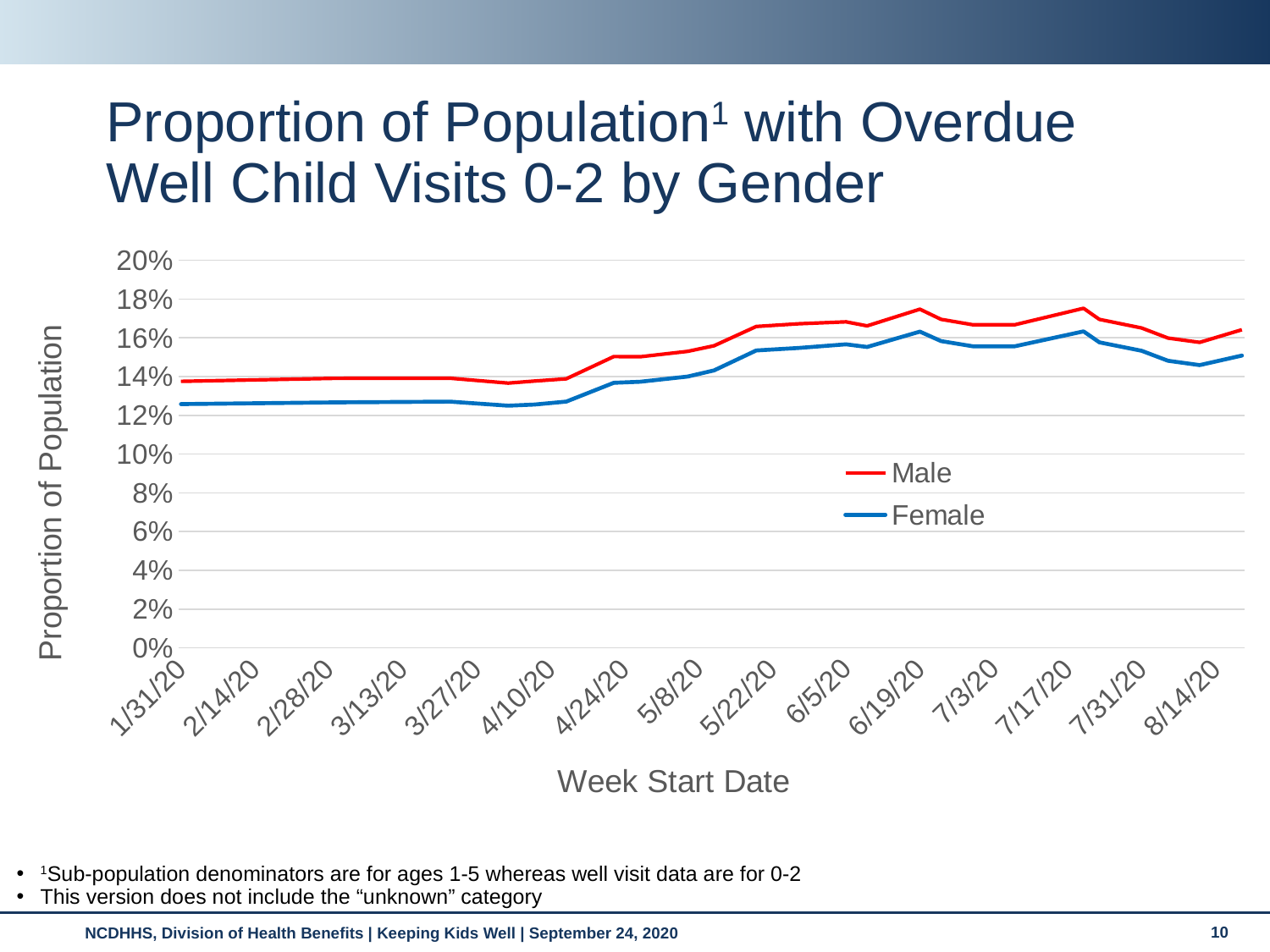
What kind of chart is shown on the slide? line chart Is the Male value at 6/19/20 greater or less than 16%? greater Which two series are shown in the legend? Male and Female How many dates are labeled on the x axis? 15 Which series has the higher value at 5/22/20, Male or Female? Male How many series does the legend list? 2 Is the Female value at 4/10/20 greater or less than 14%? less What colour is the Male line? red Is the Male value at 8/14/20 greater or less than 18%? less Does the Male line rise or fall between 4/10/20 and 5/22/20? rise Which series is higher across the whole period, Male or Female? Male